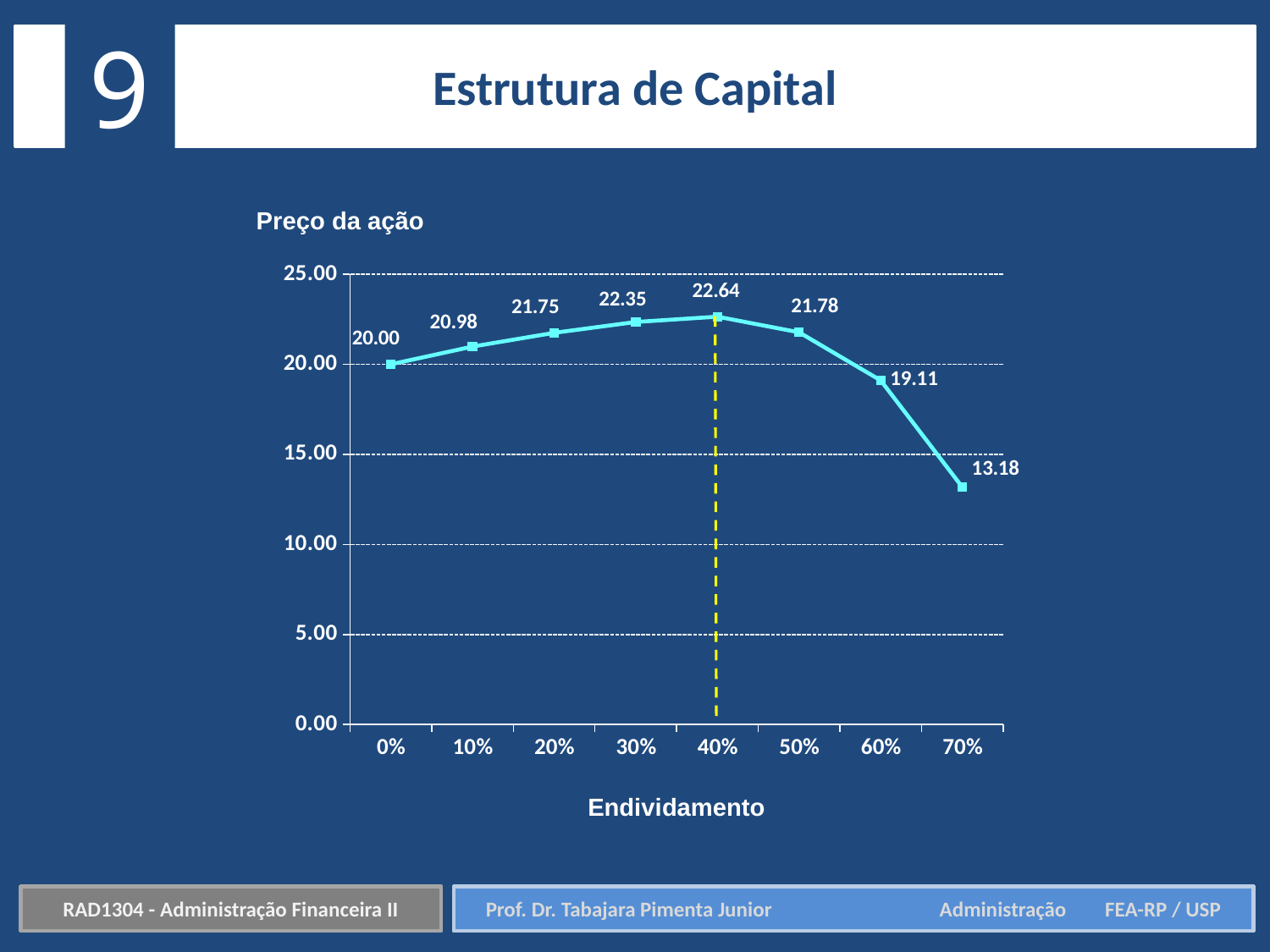
At which Endividamento level is the stock price lowest? 70% What is the stock price (Preço da ação) at 40% Endividamento? 22.64 What is the stock price at 70% Endividamento? 13.18 Does the stock price rise or fall from 40% to 70% Endividamento? fall What is the stock price at 0% Endividamento? 20.00 At which Endividamento level is the stock price highest? 40% How many Endividamento levels are plotted on the chart? 8 Which is larger, the stock price at 30% or at 50% Endividamento? 30% What kind of chart is shown on the slide? line chart What is the difference between the stock price at 40% and at 70% Endividamento? 9.46 What is the label of the x axis of the chart? Endividamento Is the stock price at 60% Endividamento greater or less than 20.00? less